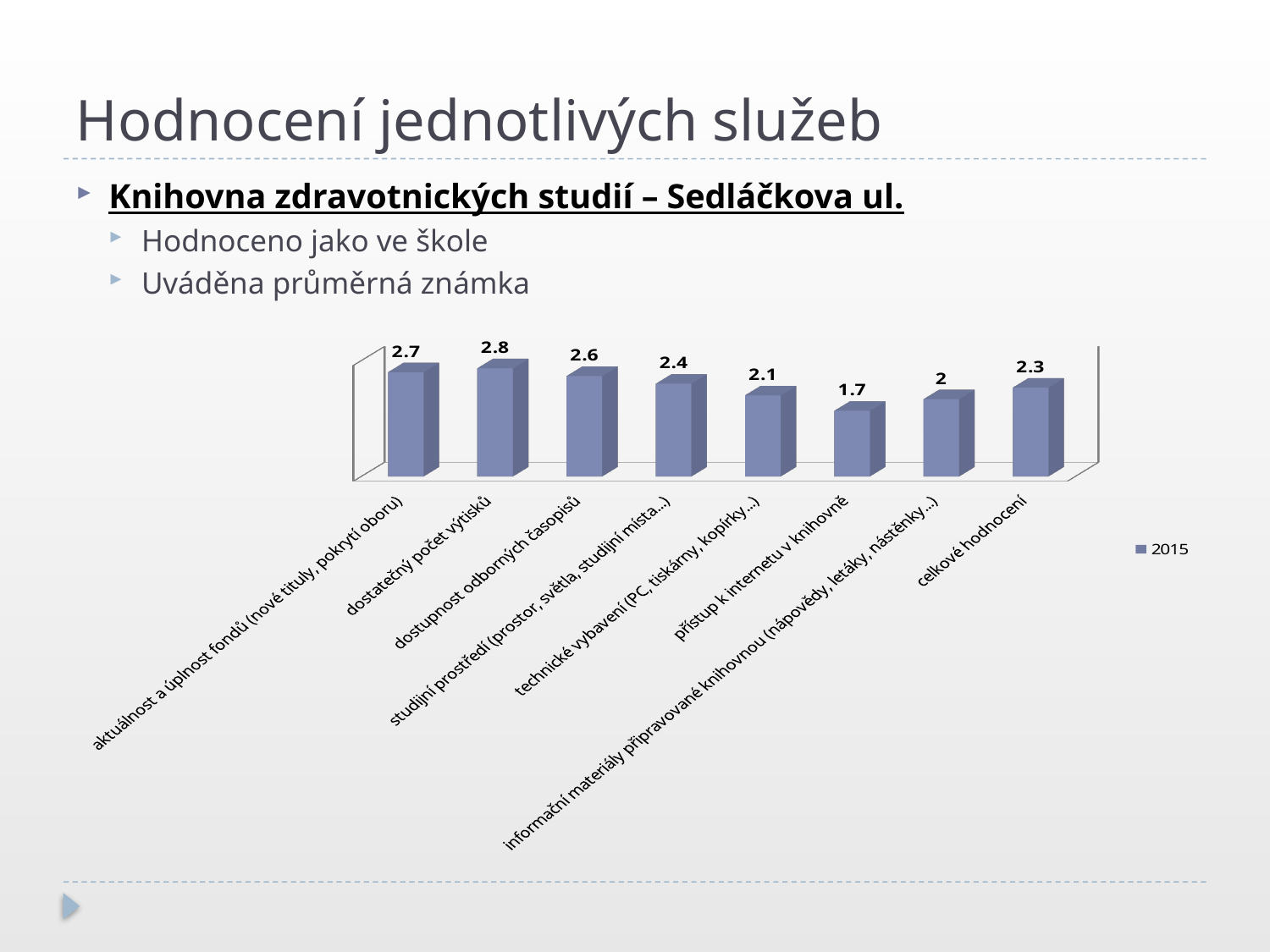
How many categories are shown in the chart? 8 What is the value for "přístup k internetu v knihovně"? 1.7 What is the value for "technické vybavení (PC, tiskárny, kopírky...)"? 2.1 Which category has the highest value? dostatečný počet výtisků What is the value for "celkové hodnocení"? 2.3 What is the difference between the values for "dostatečný počet výtisků" and "přístup k internetu v knihovně"? 1.1 Which category has the lowest value? přístup k internetu v knihovně What kind of chart is shown on the slide? bar chart What is the value for "dostatečný počet výtisků"? 2.8 What series name is shown in the chart legend? 2015 Which is larger: the value for "dostupnost odborných časopisů" or the value for "studijní prostředí (prostor, světla, studijní místa...)"? dostupnost odborných časopisů How many series does the legend list? 1